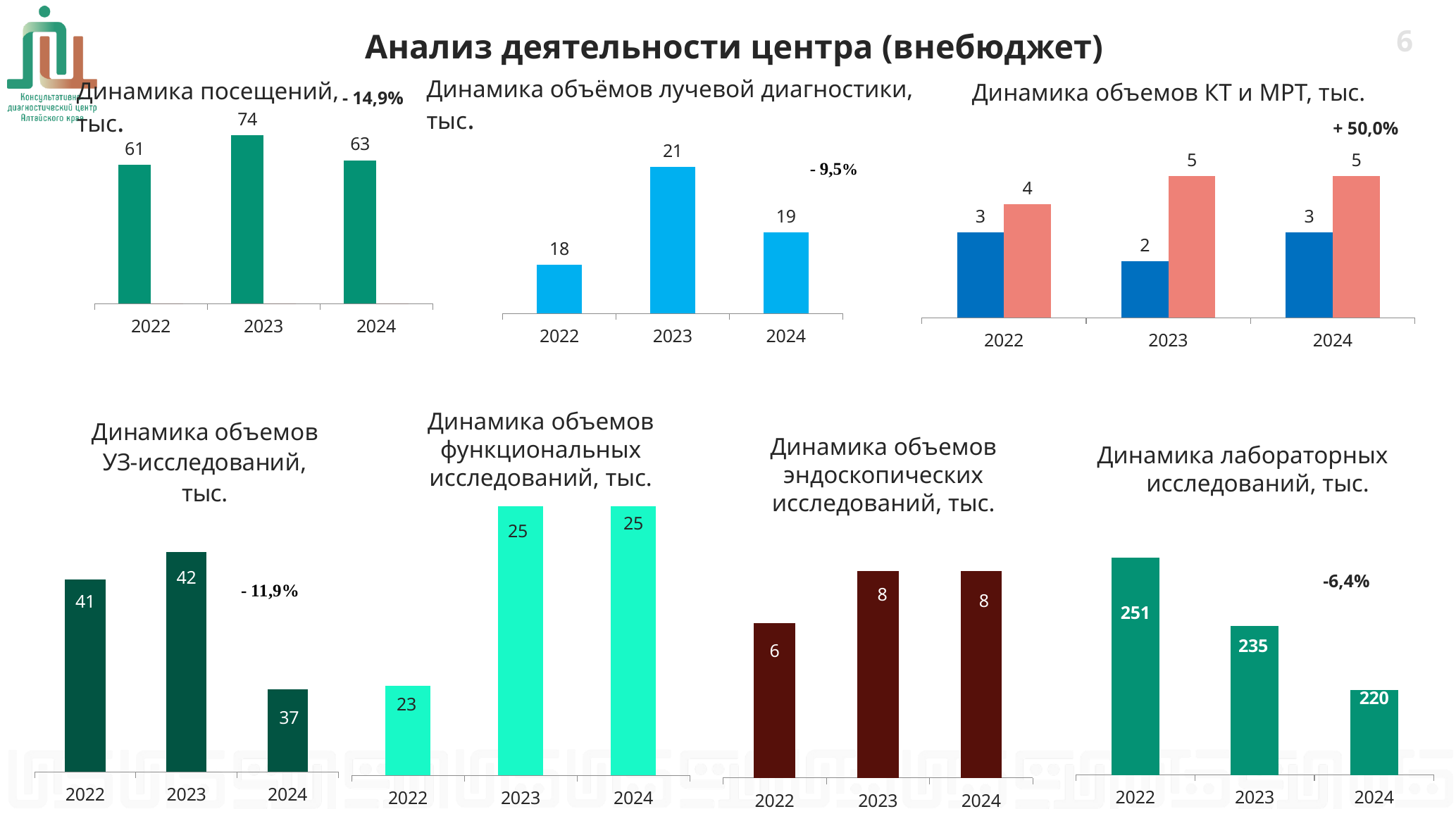
In the chart titled "Динамика посещений, тыс.", which year has the highest value? 2023 In the chart titled "Динамика объемов УЗ-исследований, тыс.", what is the value for 2024? 37 In the chart titled "Динамика объемов КТ и МРТ, тыс.", what is the value of the blue bar for 2023? 2 In the chart titled "Динамика объемов функциональных исследований, тыс.", what is the value for 2022? 23 In the chart titled "Динамика посещений, тыс.", what is the value for 2023? 74 In the chart titled "Динамика объемов КТ и МРТ, тыс.", how many years are shown on the x axis? 3 In the chart titled "Динамика объемов УЗ-исследований, тыс.", which is larger, the value for 2022 or the value for 2024? 2022 What type of chart is the one titled "Динамика лабораторных исследований, тыс."? bar chart In the chart titled "Динамика объёмов лучевой диагностики, тыс.", what is the difference between the 2023 and 2024 values? 2 In the chart titled "Динамика лабораторных исследований, тыс.", do the values rise or fall from 2022 to 2024? fall In the chart titled "Динамика объемов эндоскопических исследований, тыс.", what is the difference between the 2023 and 2022 values? 2 In the chart titled "Динамика объёмов лучевой диагностики, тыс.", which year has the lowest value? 2022